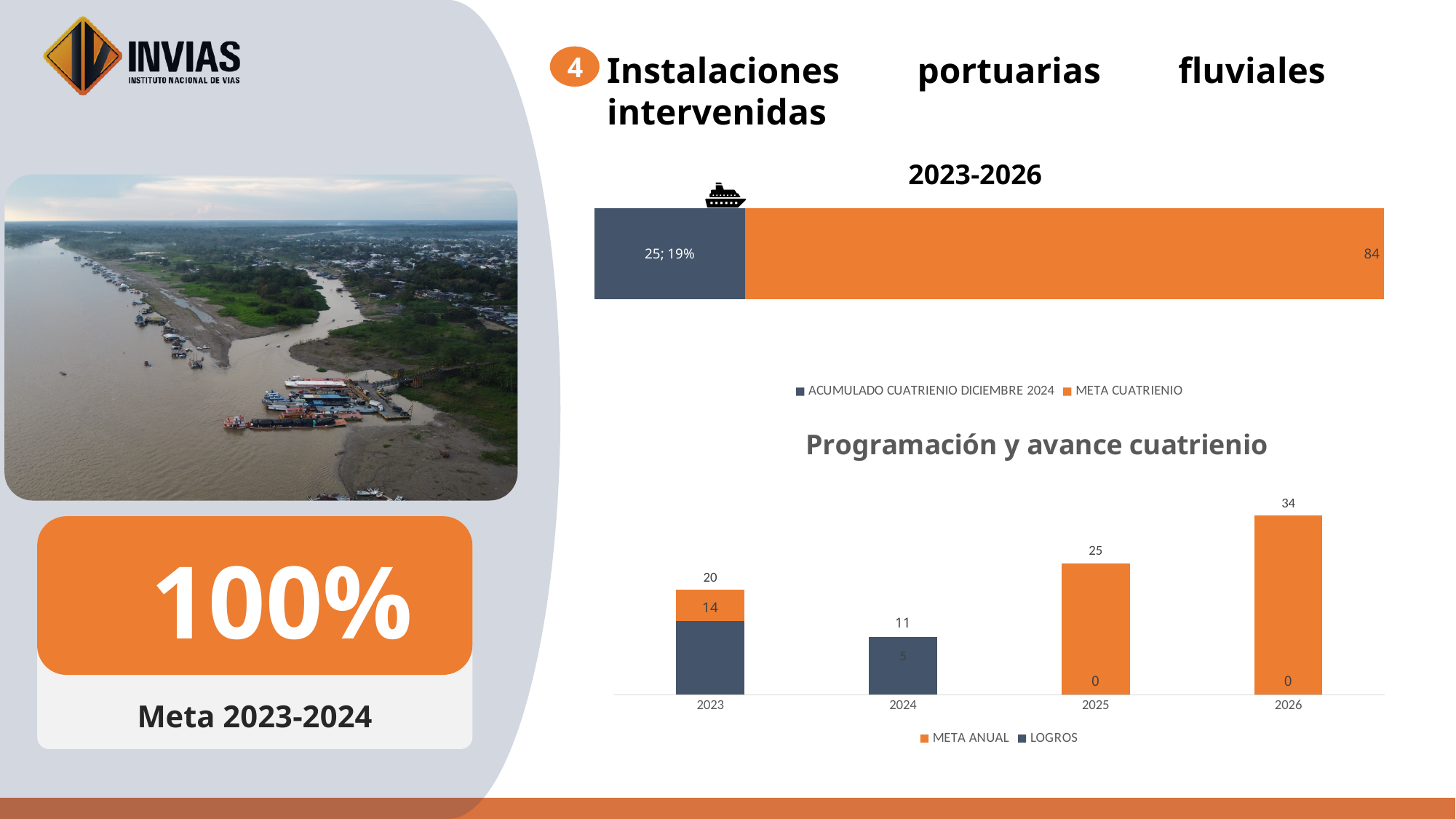
In the chart titled Programación y avance cuatrienio, what is the META ANUAL value for 2026? 34 In the chart titled Programación y avance cuatrienio, which year has the highest META ANUAL? 2026 In the chart titled Programación y avance cuatrienio, how many years are shown on the x axis? 4 In the top chart titled 2023-2026, which series has the larger value, ACUMULADO CUATRIENIO DICIEMBRE 2024 or META CUATRIENIO? META CUATRIENIO In the chart titled Programación y avance cuatrienio, what kind of chart is it? Bar chart In the chart titled Programación y avance cuatrienio, what is the LOGROS value for 2025? 0 In the chart titled Programación y avance cuatrienio, what is the META ANUAL value for 2025? 25 In the top chart titled 2023-2026, how many series does the legend list? 2 In the chart titled Programación y avance cuatrienio, which colour represents META ANUAL in the legend? Orange In the top chart titled 2023-2026, what label is printed on the ACUMULADO CUATRIENIO DICIEMBRE 2024 segment? 25; 19% In the top chart titled 2023-2026, what value is shown for META CUATRIENIO? 84 In the chart titled Programación y avance cuatrienio, what is the difference between the META ANUAL for 2026 and for 2025? 9